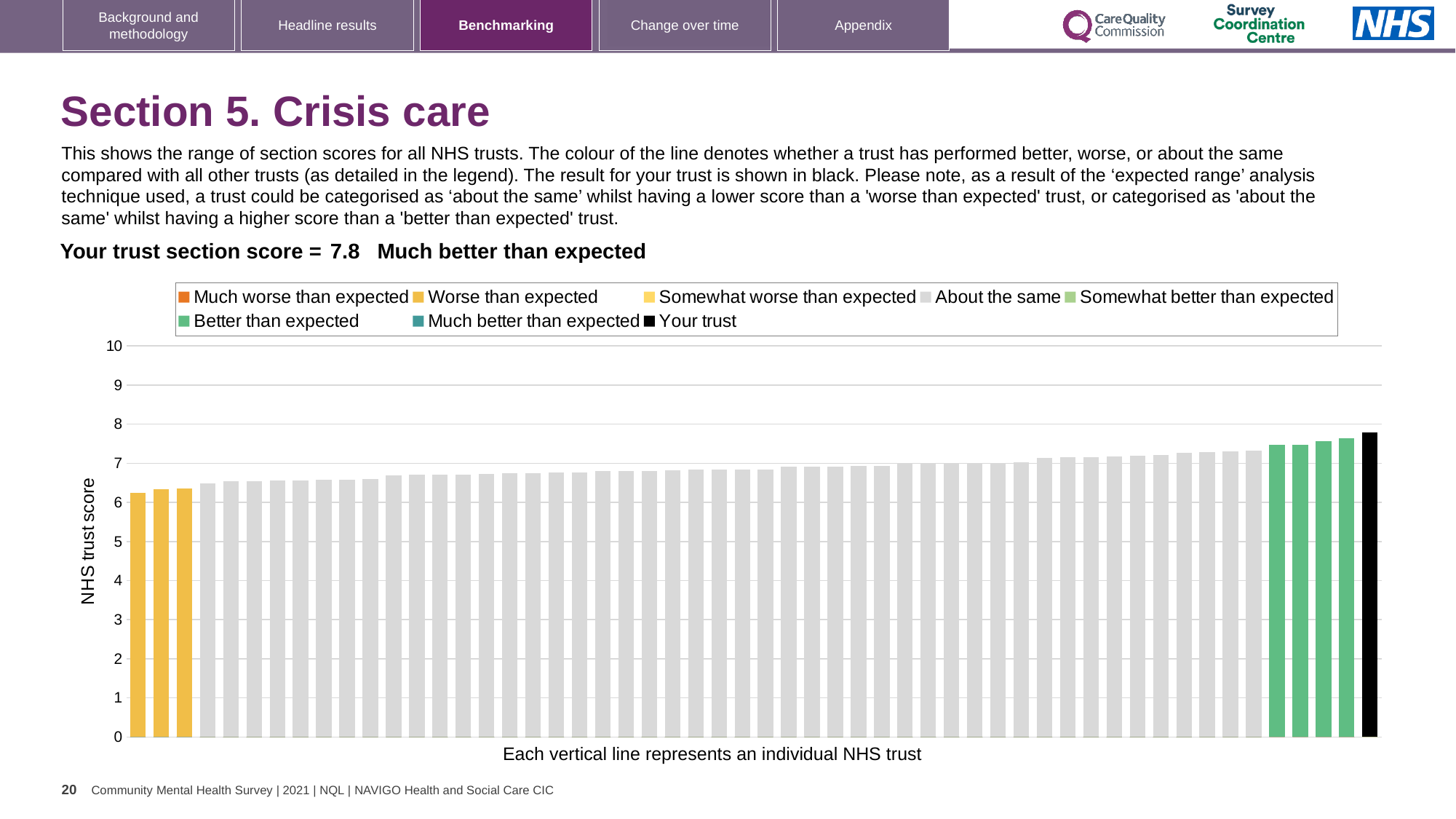
Do the bar values rise or fall from left to right along the x axis? rise How is your trust's section score categorised on the slide? Much better than expected Is the value of the leftmost (lowest) bar greater or less than 7? less Is the value of the leftmost (lowest) bar greater or less than 6? greater What is the label on the vertical axis of the chart? NHS trust score What kind of chart is shown on the slide? bar chart How many bars are coloured green (better than expected)? 4 Is the value of the black bar for your trust greater or less than 7? greater How many bars are coloured yellow (worse than expected)? 3 Which bar has the highest value in the chart? Your trust (the black bar) What is the section score for your trust shown on the slide? 7.8 How many entries does the legend list? 8